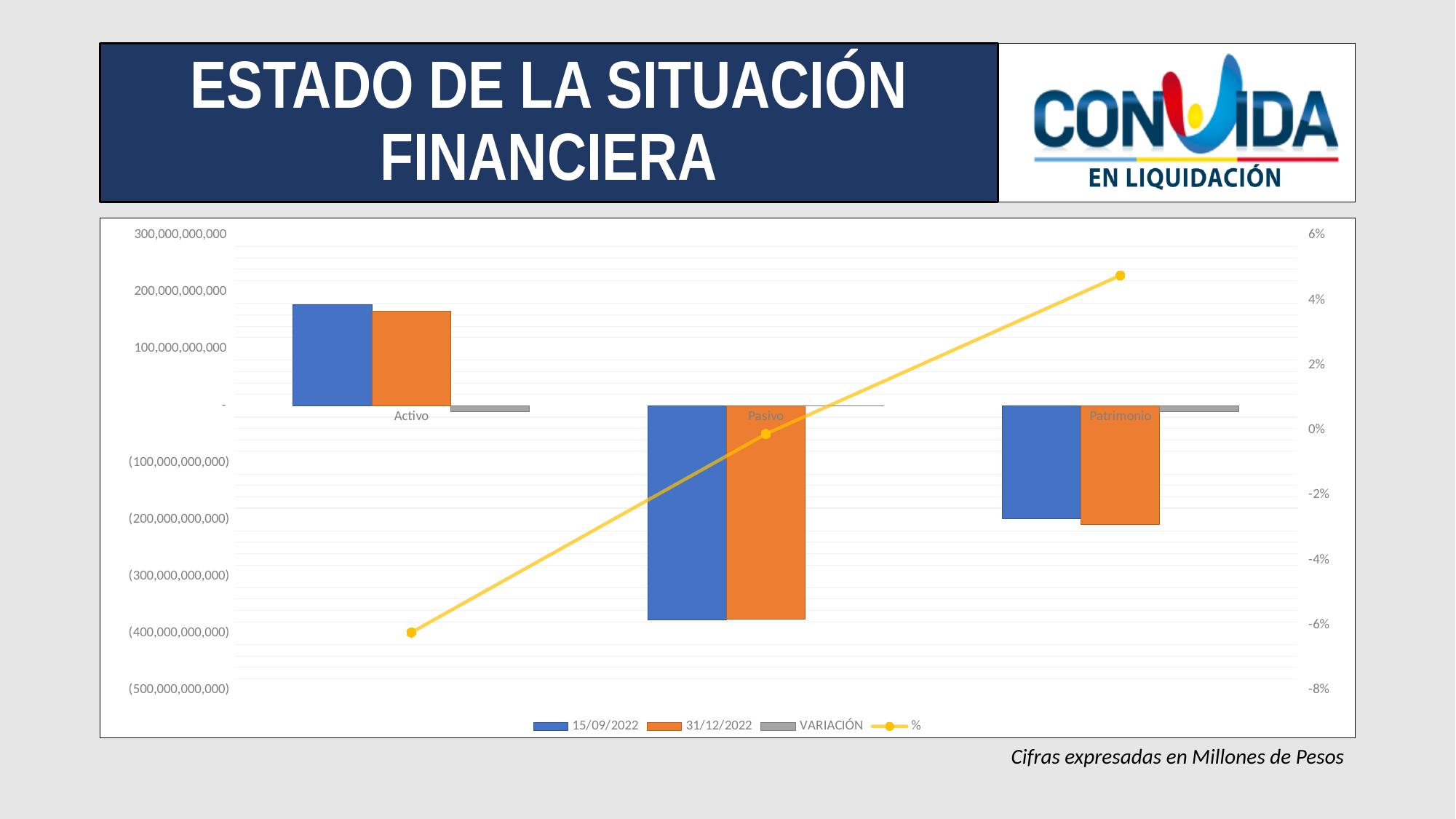
Does the % line rise or fall from Activo to Patrimonio? rises Is the % line value for Activo greater or less than -4%? less For Activo, which is larger: the 15/09/2022 value or the 31/12/2022 value? 15/09/2022 What kind of chart is shown on the slide? A bar chart combined with a line Which category has the highest value for the 15/09/2022 series? Activo Is the 31/12/2022 value for Patrimonio greater or less than (100,000,000,000)? less How many series does the chart legend list? 4 Which category has the lowest value for the 31/12/2022 series? Pasivo How many categories are shown on the x axis of the chart? 3 Is the 15/09/2022 value for Activo greater or less than 100,000,000,000? greater